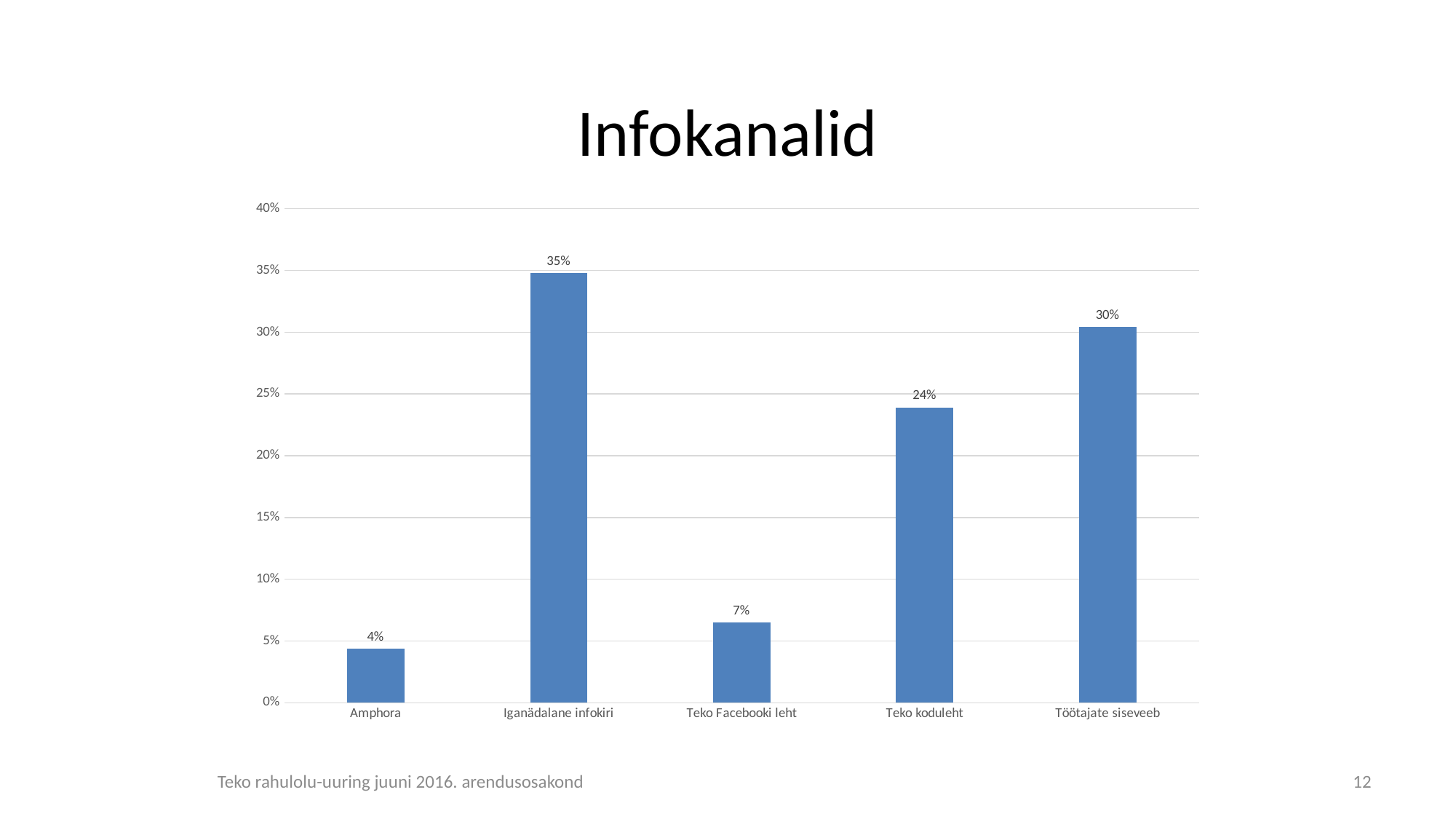
What is the value for Iganädalane infokiri? 35% What is the title of the chart? Infokanalid Which category has the lowest value? Amphora What is the value for Amphora? 4% Which category has the highest value? Iganädalane infokiri What is the value for Töötajate siseveeb? 30% How many categories are shown on the chart? 5 Which is larger, the value for Teko Facebooki leht or the value for Teko koduleht? Teko koduleht Is the value for Teko Facebooki leht greater or less than 10%? less What kind of chart is shown on the slide? bar chart What is the difference between the values for Iganädalane infokiri and Töötajate siseveeb? 5% What is the value for Teko koduleht? 24%